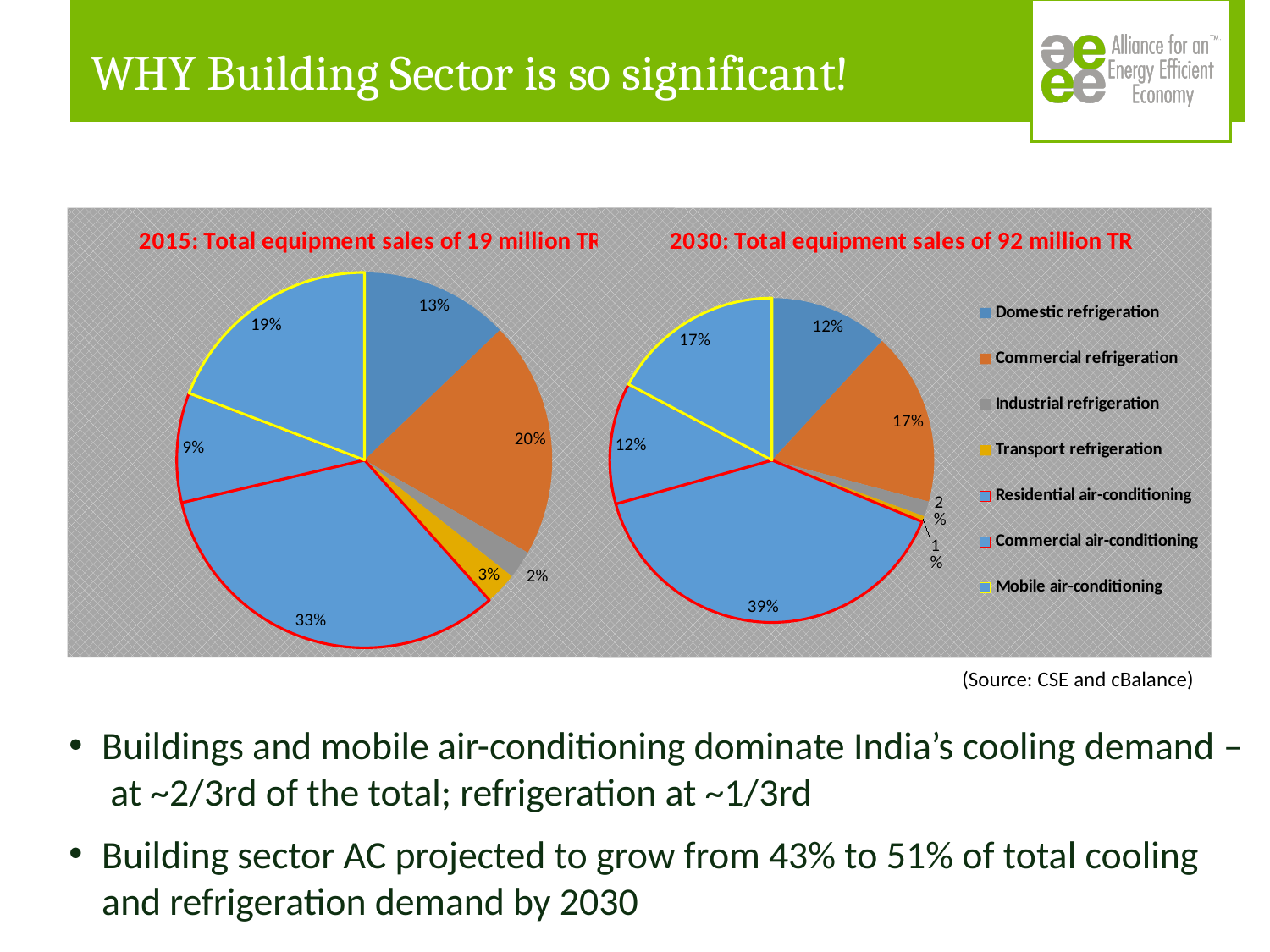
What is the difference between the Residential air-conditioning share in 2030 and in 2015? 6% In the 2015 pie chart, which category has the smallest share? Industrial refrigeration In the 2015 pie chart, which category has the largest share? Residential air-conditioning How many categories does the legend list for the pie charts? 7 In the 2030 pie chart, which category has the smallest share? Transport refrigeration In the 2015 pie chart, which is larger: Mobile air-conditioning or Domestic refrigeration? Mobile air-conditioning In the 2015 pie chart, what share is Residential air-conditioning? 33% In the 2015 pie chart, what share is Commercial refrigeration? 20% In the 2030 pie chart, what share is Residential air-conditioning? 39% In the 2030 pie chart, what share is Mobile air-conditioning? 17% What type of chart is used to show the 2015 and 2030 equipment sales? Pie chart What is the title of the right-hand pie chart? 2030: Total equipment sales of 92 million TR